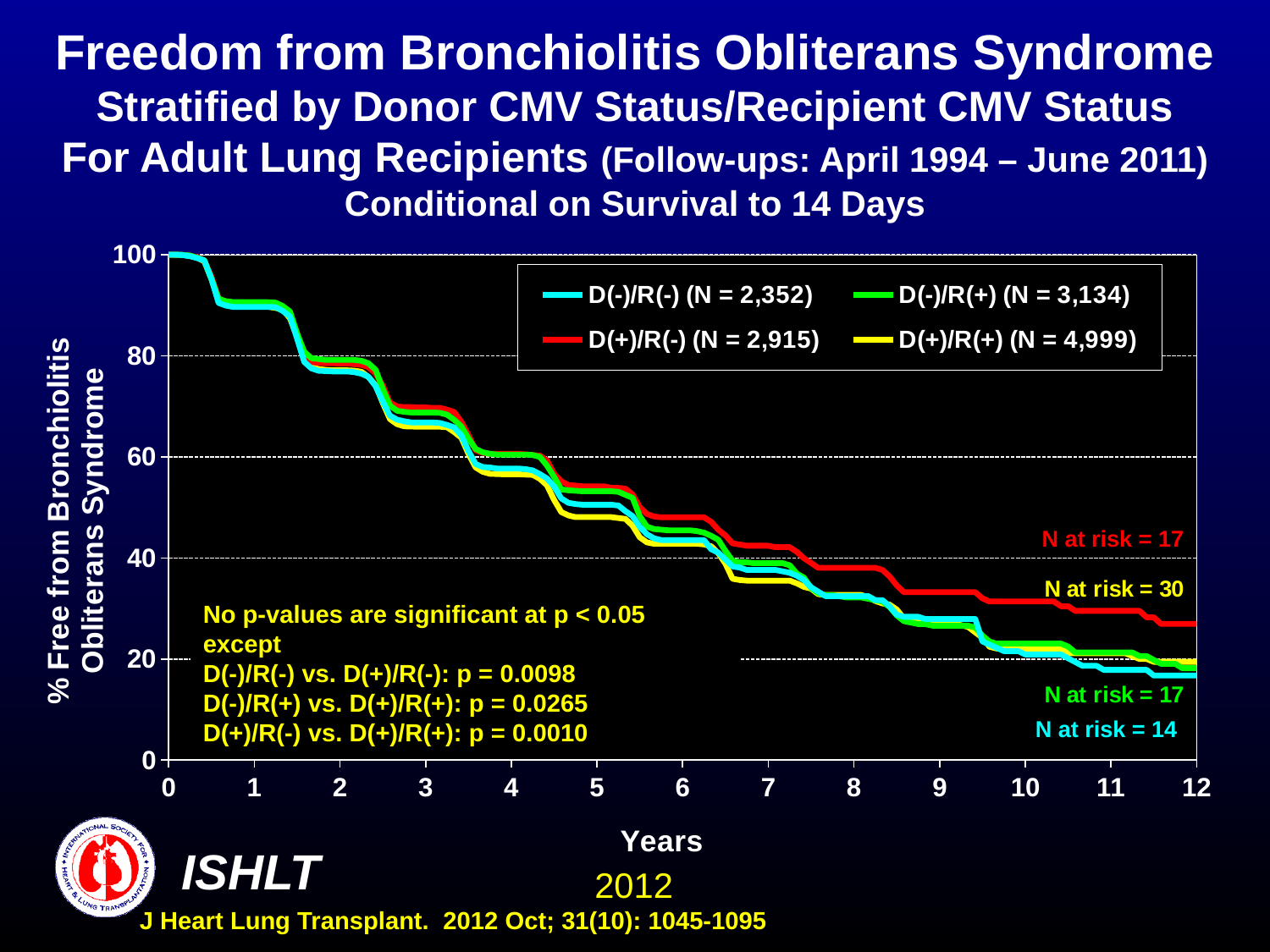
What is the largest 'N at risk' value shown on the chart? 30 What is the N for the D(-)/R(-) group in the legend? 2,352 Which group has the smallest N in the legend? D(-)/R(-) Do the curves rise or fall as the years increase? fall What is the difference in N between the D(+)/R(+) group and the D(-)/R(-) group? 2,647 What is the N for the D(+)/R(+) group in the legend? 4,999 Which group has the largest N in the legend? D(+)/R(+) At 12 years, which curve is higher: D(+)/R(-) or D(-)/R(-)? D(+)/R(-) Is the value for D(+)/R(-) at 6 years greater or less than 40? greater Is the value for D(+)/R(-) at 12 years greater or less than 20? greater How many series does the legend list? 4 What kind of chart is shown on the slide? line chart